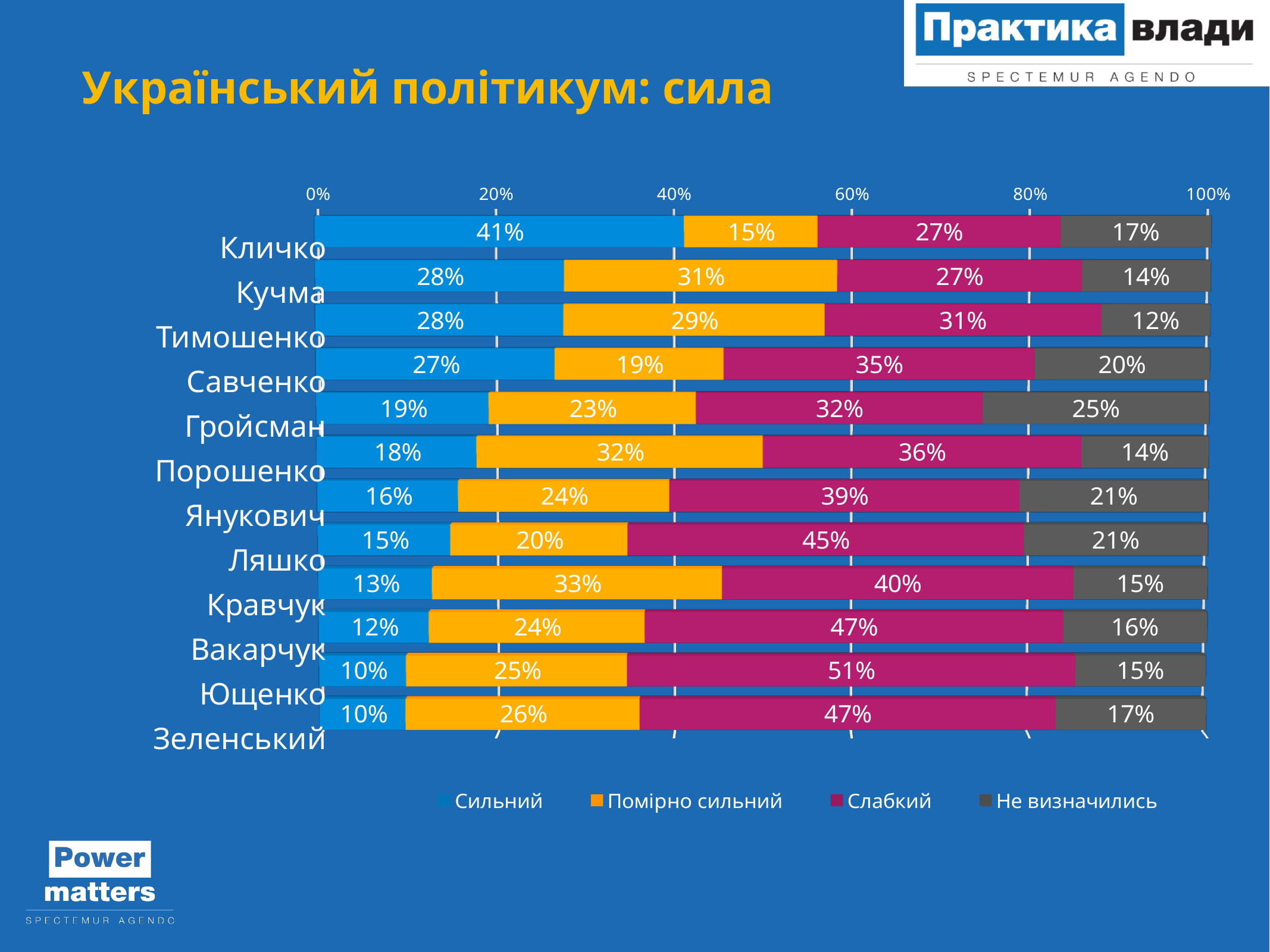
What percentage of respondents rated Кличко as Сильний? 41% Which politician has the highest Сильний value? Кличко Which politician has the lowest Не визначились value? Тимошенко What is the Не визначились value for Гройсман? 25% What is the difference between the Слабкий values for Ляшко and Кличко? 18% What kind of chart is shown on the slide? Stacked bar chart How many politicians are shown on the chart? 12 What is the title of the slide? Український політикум: сила What is the total of the Сильний and Помірно сильний values for Кучма? 59% What is the Слабкий value for Ющенко? 51% How many series does the legend list? 4 Which is larger: the Помірно сильний value for Кравчук or for Порошенко? Кравчук